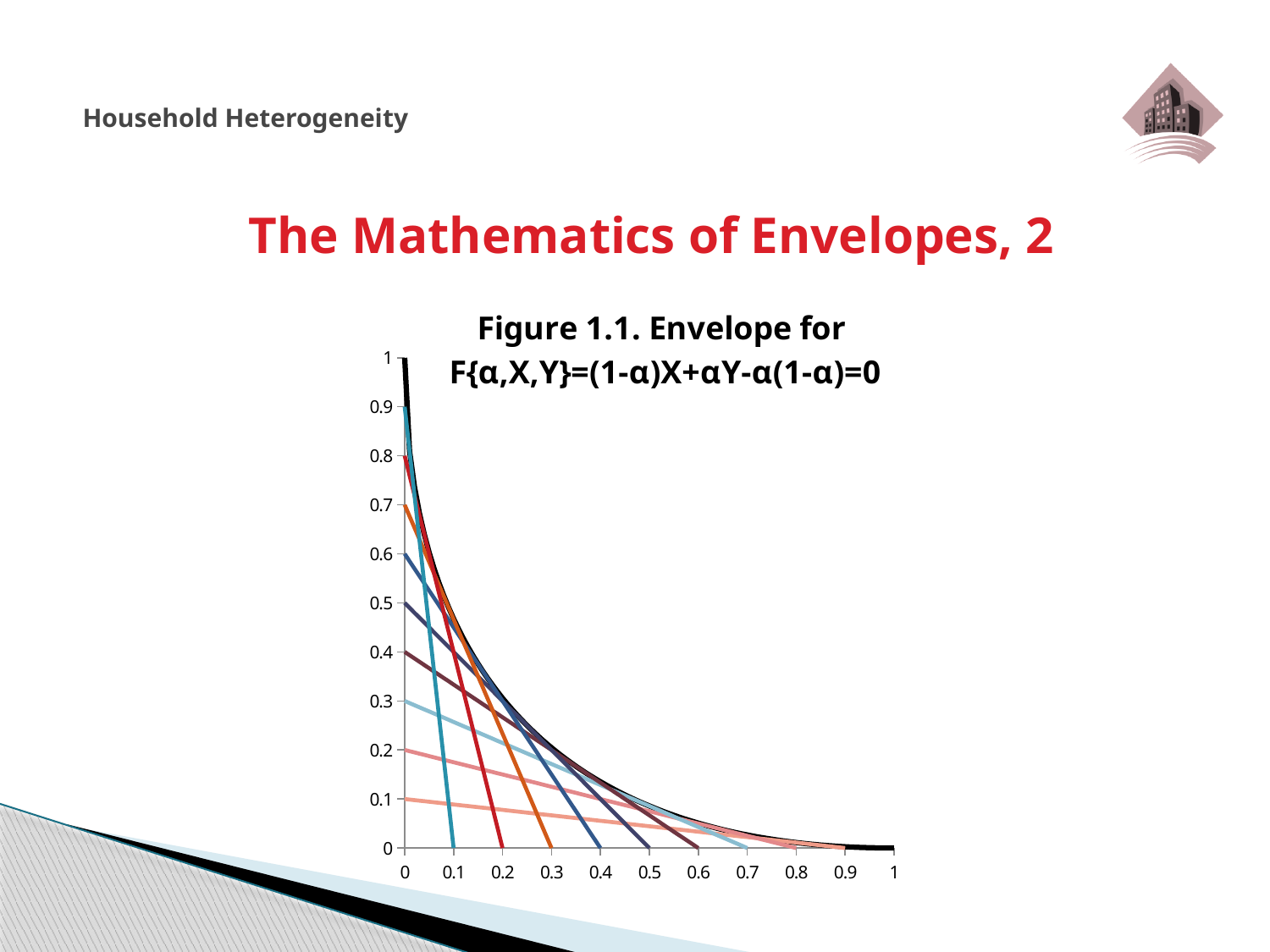
At what X value does the straight line that meets the vertical axis at 0.2 cross the horizontal axis? 0.8 Is the value of the envelope curve at X = 0.05 greater or less than 0.5? greater Does the envelope curve rise or fall as X increases from 0 to 1? fall At what Y value does the straight line that crosses the horizontal axis at 0.5 meet the vertical axis? 0.5 Which is larger: the Y-intercept of the line crossing the horizontal axis at 0.1, or the Y-intercept of the line crossing the horizontal axis at 0.9? the line crossing at 0.1 What is the title of the chart? Figure 1.1. Envelope for F{α,X,Y}=(1-α)X+αY-α(1-α)=0 How many straight lines are drawn beneath the envelope curve? 9 Is the value of the envelope curve at X = 0.4 greater or less than 0.2? less What is the highest value shown on the vertical axis? 1 Is the value of the envelope curve at X = 0.6 greater or less than 0.1? less What kind of chart is shown on the slide? line chart At what X value does the straight line that meets the vertical axis at 0.9 cross the horizontal axis? 0.1